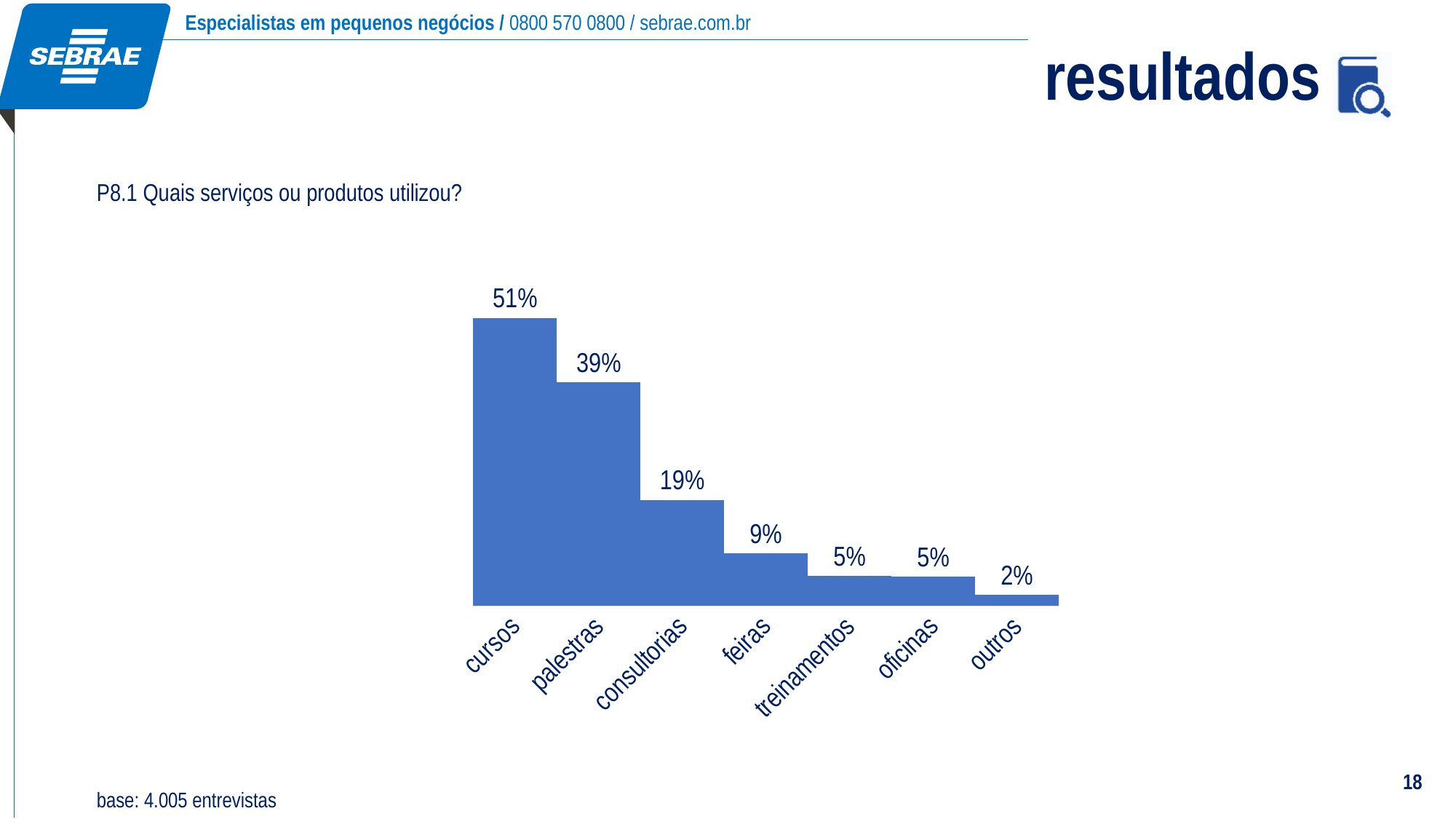
What is the value for feiras? 9% What is the value for consultorias? 19% What is the value for outros? 2% How many categories are shown in the chart? 7 What is the difference between the values for cursos and palestras? 12% What is the value for cursos? 51% What kind of chart is shown on the slide? bar chart Which category has the highest value? cursos What is the value for palestras? 39% Do the values rise or fall from left to right along the x axis? fall Which category has the lowest value? outros Which is larger, the value for consultorias or the value for feiras? consultorias